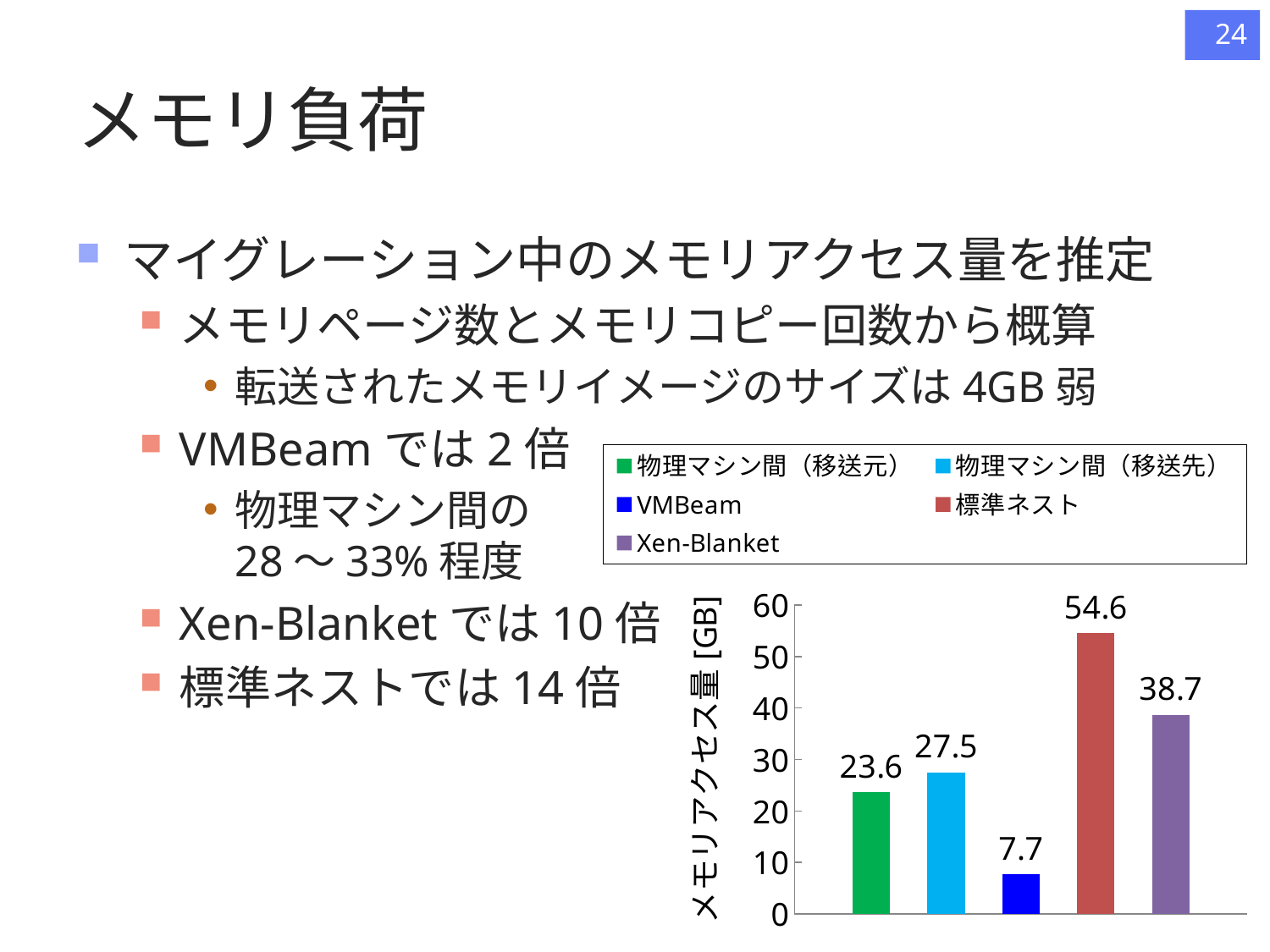
What is the memory access amount for 物理マシン間（移送先）? 27.5 What is the memory access amount for 標準ネスト? 54.6 What is the memory access amount for Xen-Blanket? 38.7 Which series has the highest memory access amount? 標準ネスト What is the difference between the memory access amounts of 標準ネスト and Xen-Blanket? 15.9 What is the memory access amount for VMBeam? 7.7 How many series does the legend list? 5 Which is larger, the memory access amount for Xen-Blanket or for 物理マシン間（移送元）? Xen-Blanket What is the label of the vertical axis of the chart? メモリアクセス量 [GB] Which series has the lowest memory access amount? VMBeam What kind of chart is shown on the slide? bar chart What is the difference between the memory access amounts of 物理マシン間（移送先） and 物理マシン間（移送元）? 3.9